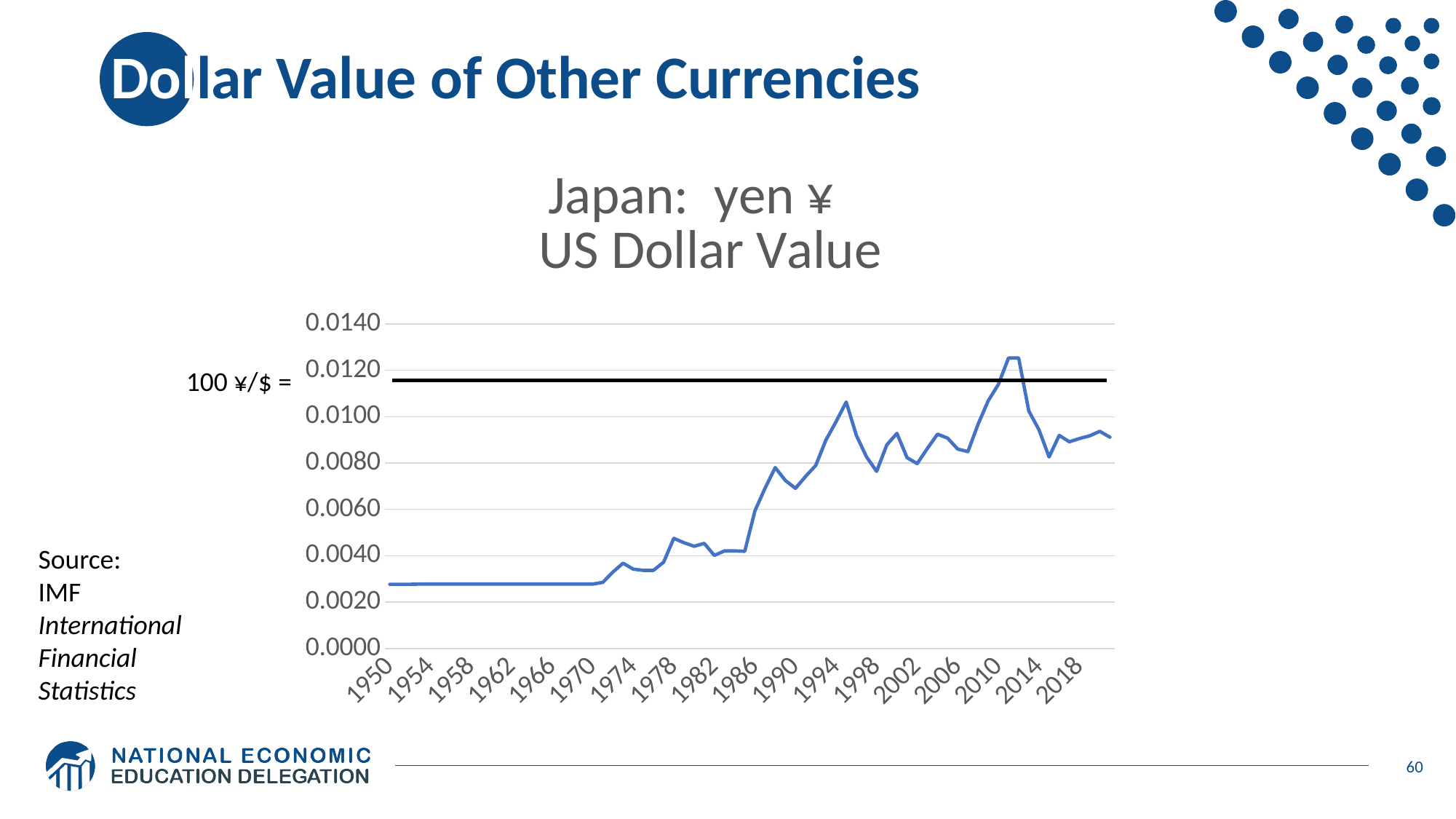
Is the value for 1970 greater or less than 0.0040? less Is the value for 2018 greater or less than 0.0080? greater Overall, does the US dollar value of the yen rise or fall from 1950 to 2018? rise Is the value for 1978 greater or less than 0.0040? greater How many year labels are shown on the x axis? 18 What is the title of the chart? Japan: yen ¥ US Dollar Value Which is larger, the value for 1950 or the value for 2018? 2018 What does the horizontal black reference line on the chart represent? 100 ¥/$ What kind of chart is shown on the slide? line chart